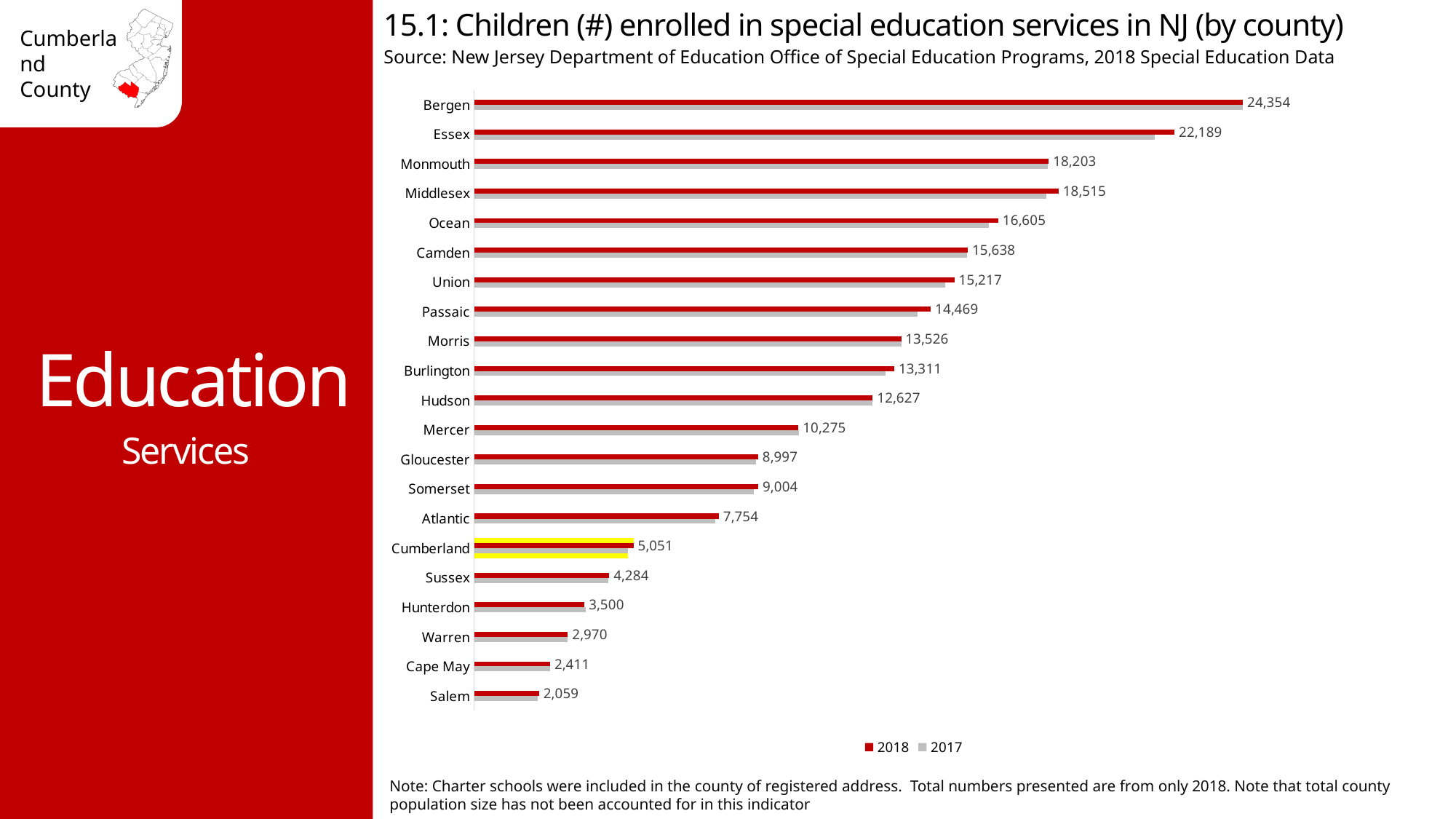
What is the difference between the 2018 values for Cumberland and Sussex? 767 Which county's bars are highlighted in yellow? Cumberland Which county has the highest 2018 value? Bergen How many counties are shown on the chart? 21 What is the 2018 value for Bergen? 24,354 Which county has the lowest 2018 value? Salem How many series does the legend list? 2 What is the 2018 value for Ocean? 16,605 What kind of chart is this? Bar chart What is the 2018 value for Cumberland? 5,051 Which has the larger 2018 value, Middlesex or Monmouth? Middlesex What is the difference between the 2018 values for Bergen and Essex? 2,165